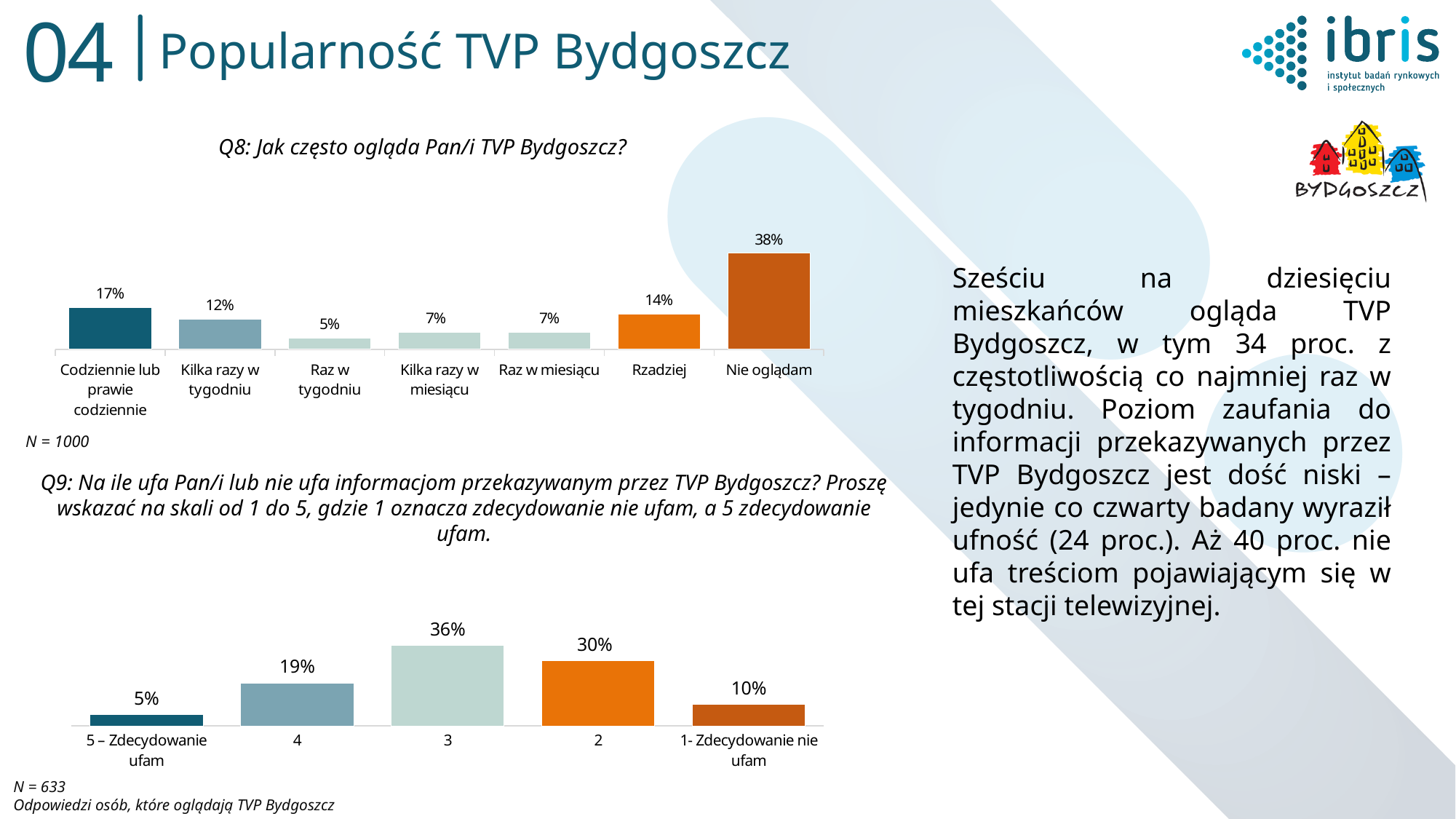
What type of chart is the Q9 chart (bottom)? Bar chart In the Q9 chart (bottom), what is the value for '1- Zdecydowanie nie ufam'? 10% In the Q9 chart (bottom), which is larger: the value for '4' or the value for '2'? 2 In the Q8 chart (top), what is the value for 'Nie oglądam'? 38% In the Q8 chart (top), which category has the lowest value? Raz w tygodniu In the Q9 chart (bottom), what is the difference between the values for '3' and '2'? 6% In the Q9 chart (bottom), how many categories are shown? 5 In the Q9 chart (bottom), what is the value for '3'? 36% In the Q8 chart (top), how many categories are shown? 7 In the Q8 chart (top), which category has the highest value? Nie oglądam In the Q8 chart (top), what is the value for 'Codziennie lub prawie codziennie'? 17% In the Q8 chart (top), what is the difference between 'Nie oglądam' and 'Rzadziej'? 24%